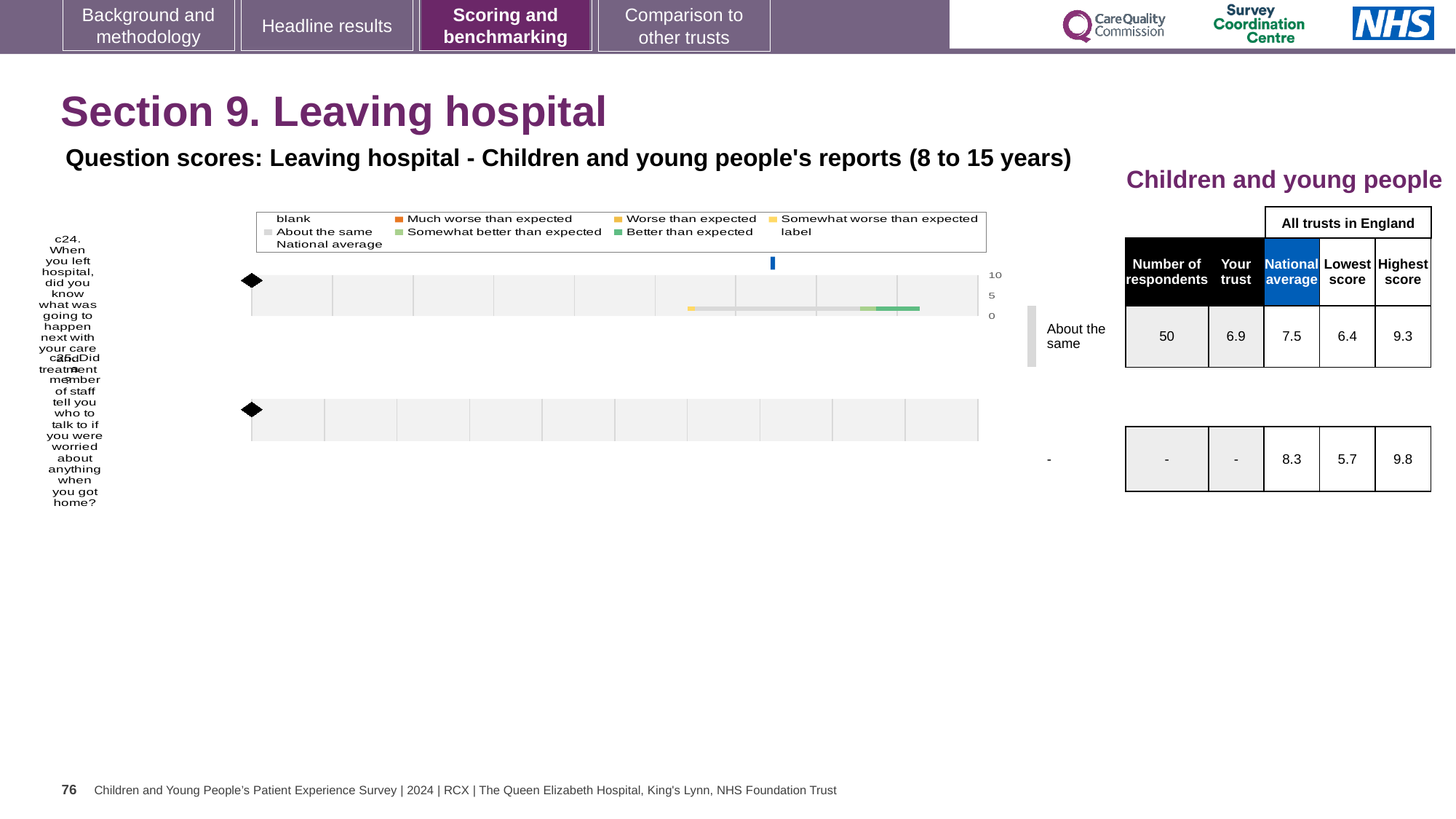
In the table beside the chart, what is the difference between the highest score and the lowest score for question c24? 2.9 In the table beside the chart, what benchmark category is given for question c24? About the same In the table beside the chart, what is the national average for question c24? 7.5 What is the highest tick value shown on the axis of the Leaving hospital chart? 10 How many entries does the legend of the Leaving hospital chart list? 9 In the table beside the chart, which is larger for question c24: the 'Your trust' score or the national average? National average Which legend entry in the Leaving hospital chart is shown in orange? Much worse than expected In the table beside the chart, what is the 'Your trust' score for question c24? 6.9 In the table beside the chart, what is the highest score for question c25? 9.8 In the table beside the chart, what is the number of respondents for question c24? 50 What kind of chart is used to show the question scores for Leaving hospital? bar chart How many questions (categories) are plotted in the Leaving hospital chart? 2